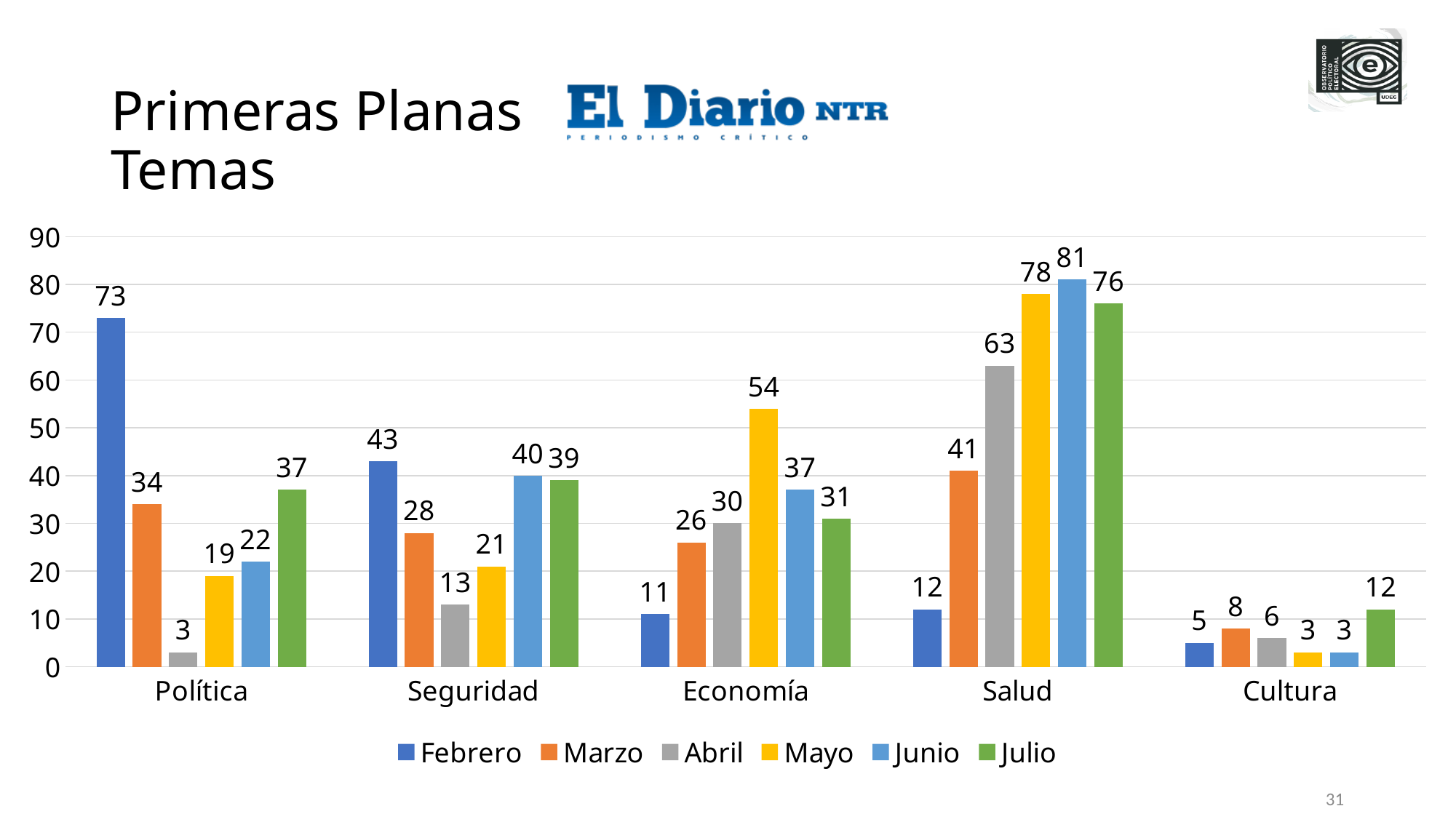
Is the value for Abril in the Salud category greater or less than 60? greater What is the value for Febrero in the Política category? 73 What is the difference between the Febrero and Marzo values in the Política category? 39 How many categories are shown on the x axis? 5 Which is larger in the Seguridad category, the Junio value or the Julio value? Junio What is the value for Junio in the Salud category? 81 How many series does the legend list? 6 Which month has the highest value in the Salud category? Junio Which month has the lowest value in the Política category? Abril What is the value for Mayo in the Economía category? 54 What kind of chart is shown on the slide? bar chart Which colour represents Mayo in the legend? yellow